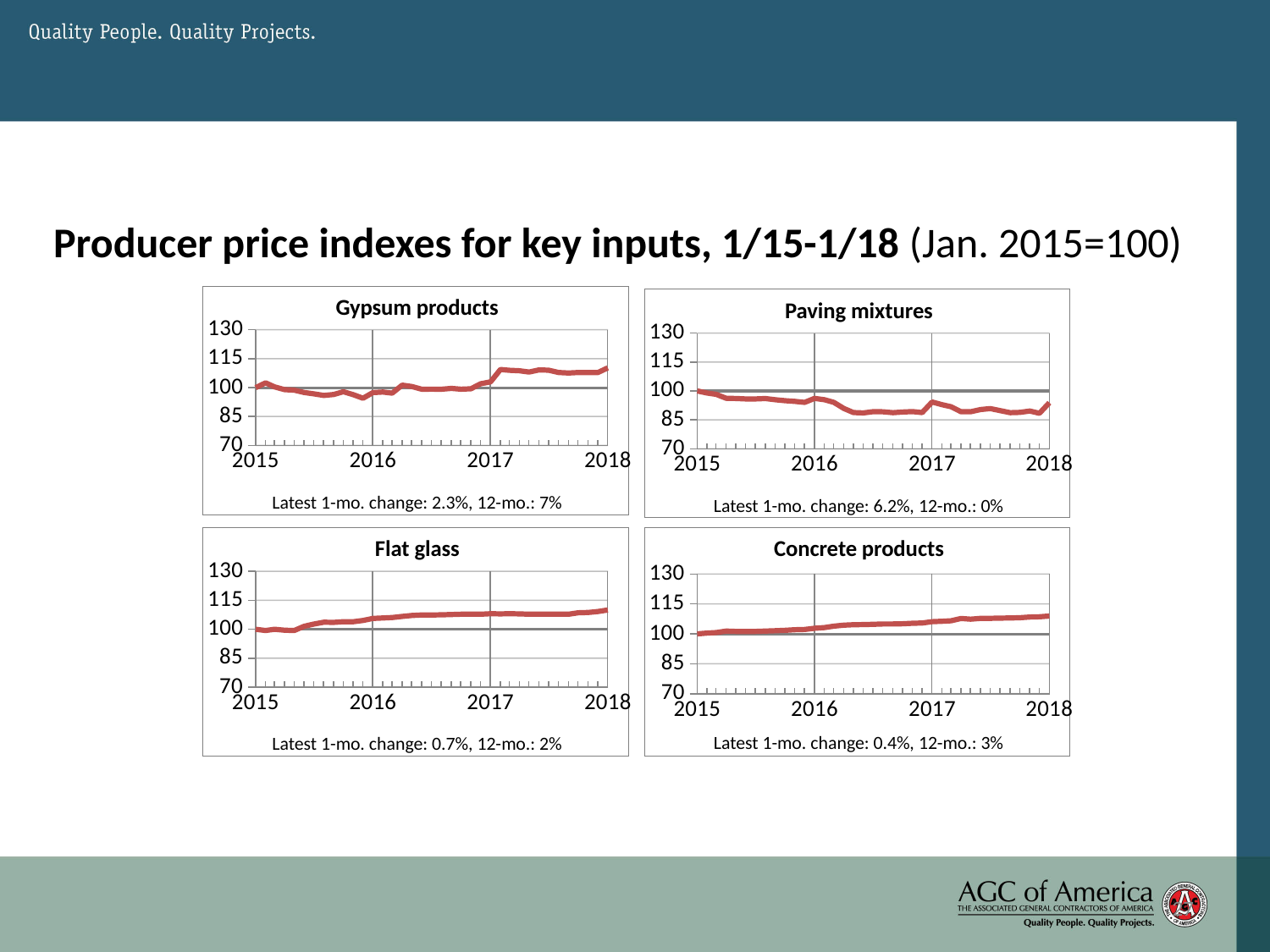
In the Paving mixtures chart, is the value at 2018 greater or less than 85? greater At 2018, which is higher: the Flat glass index or the Paving mixtures index? Flat glass According to the caption under the Paving mixtures chart, what is the latest 1-month change? 6.2% Which of the four charts ends at the lowest index value in 2018? Paving mixtures What kind of chart is used in the Gypsum products panel? line chart In the Concrete products chart, do values generally rise or fall from 2015 to 2018? rise How many charts are shown on the slide? 4 In the Concrete products chart, is the value at 2018 greater or less than 115? less In the Paving mixtures chart, do values generally rise or fall from 2015 to 2018? fall In the Gypsum products chart, is the value at 2018 greater or less than 100? greater